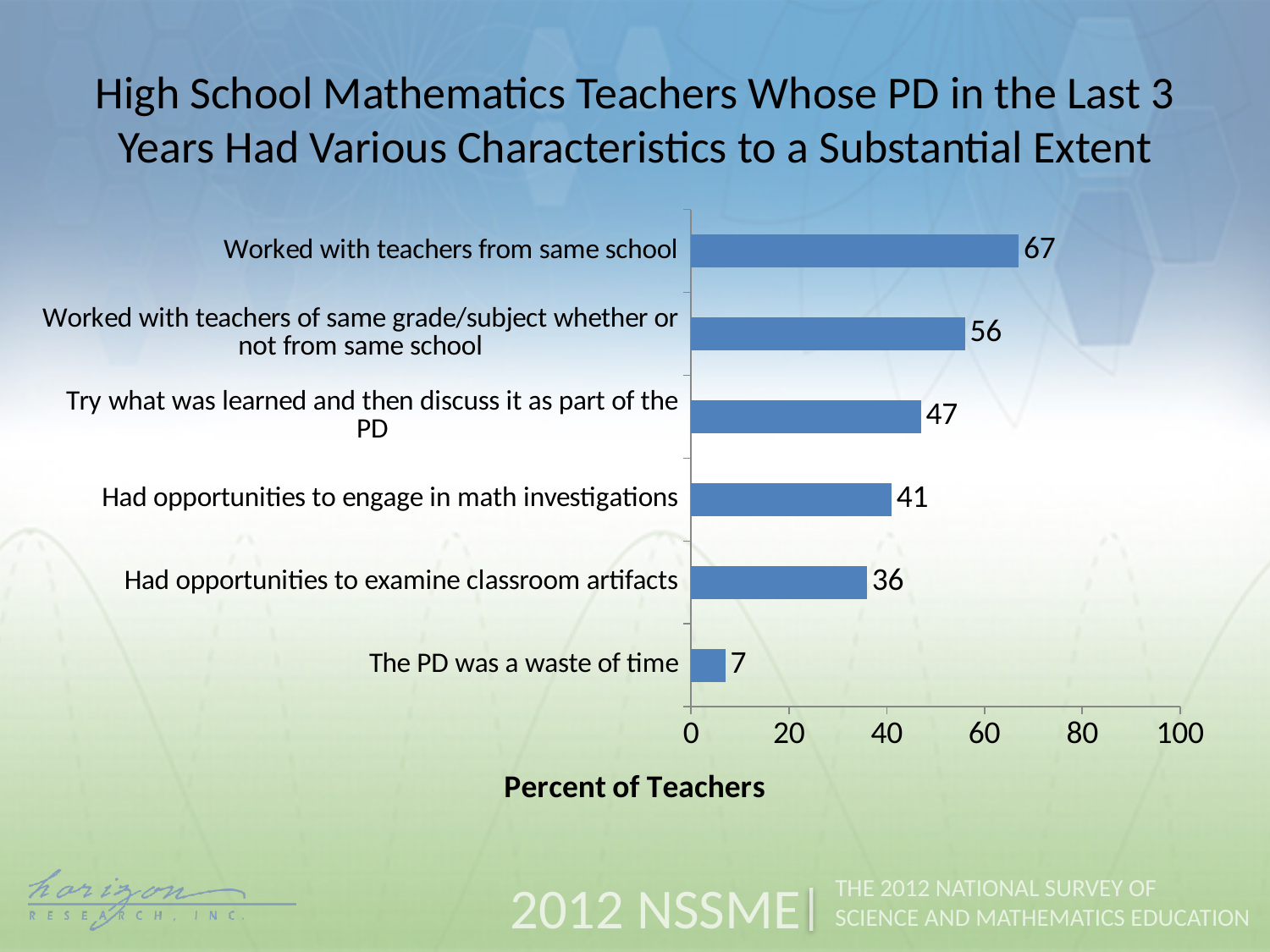
Is the value for 'Had opportunities to engage in math investigations' greater or less than 40? greater Which characteristic has the lowest percent of teachers? The PD was a waste of time What is the label of the horizontal axis? Percent of Teachers Which characteristic has the highest percent of teachers? Worked with teachers from same school How many categories are shown in the chart? 6 What is the difference between 'Worked with teachers from same school' and 'Worked with teachers of same grade/subject whether or not from same school'? 11 What kind of chart is shown on the slide? bar chart What is the value for 'Had opportunities to examine classroom artifacts'? 36 What is the difference between 'Had opportunities to examine classroom artifacts' and 'The PD was a waste of time'? 29 What percent of teachers said the PD was a waste of time? 7 What percent of teachers worked with teachers from the same school? 67 Which is larger: 'Try what was learned and then discuss it as part of the PD' or 'Had opportunities to engage in math investigations'? Try what was learned and then discuss it as part of the PD